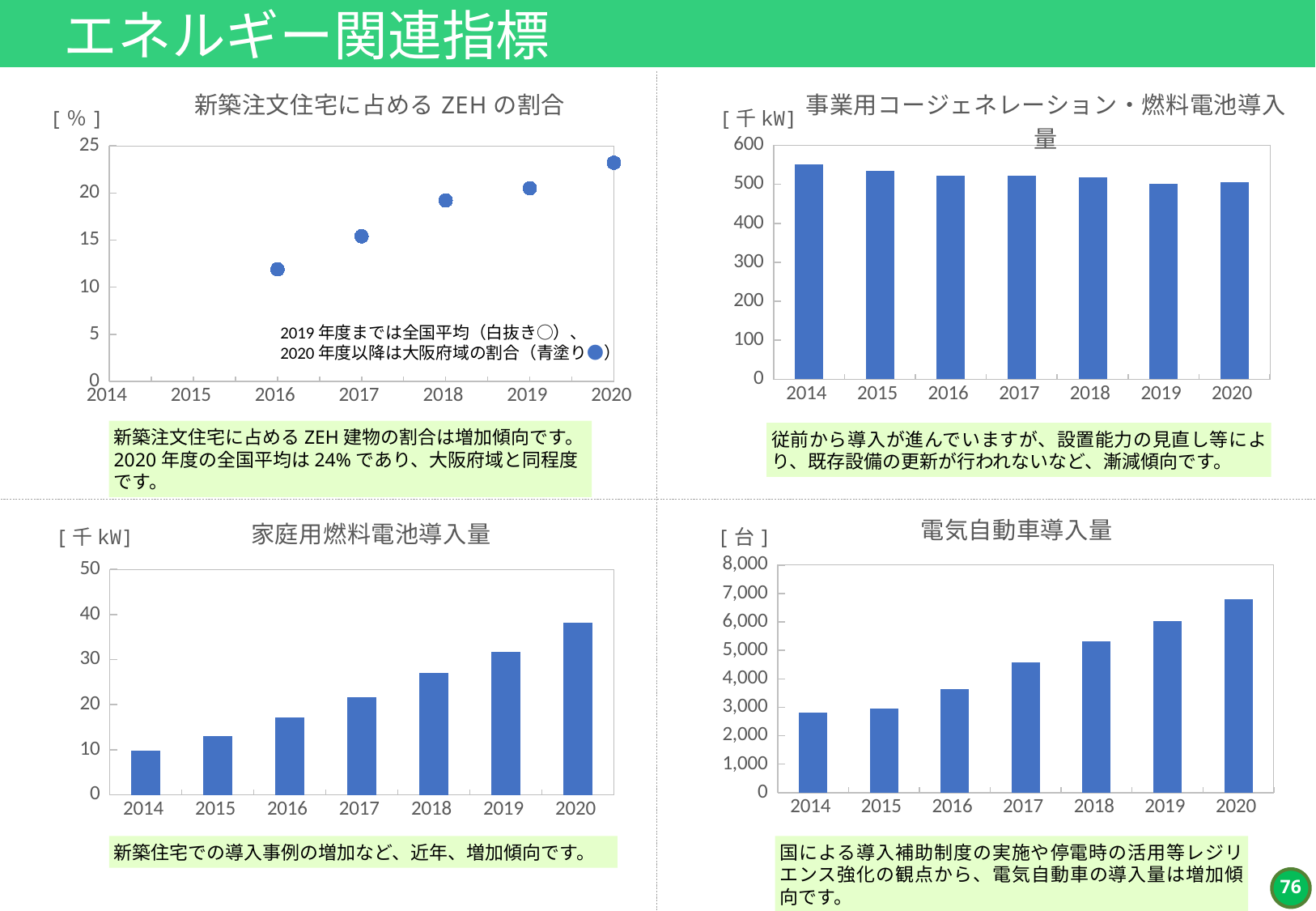
In the chart titled 事業用コージェネレーション・燃料電池導入量, which year has the highest value? 2014 In the chart titled 新築注文住宅に占めるZEHの割合, is the value for 2020 greater or less than 20? greater In the chart titled 家庭用燃料電池導入量, how many bars are shown? 7 In the chart titled 電気自動車導入量, which is larger, the value for 2017 or the value for 2019? 2019 In the chart titled 家庭用燃料電池導入量, is the value for 2020 greater or less than 30? greater In the chart titled 電気自動車導入量, is the value for 2014 greater or less than 3,000? less In the chart titled 家庭用燃料電池導入量, which year has the lowest value? 2014 In the chart titled 新築注文住宅に占めるZEHの割合, what kind of chart is it? scatter chart In the chart titled 新築注文住宅に占めるZEHの割合, how many data points are plotted? 5 In the chart titled 新築注文住宅に占めるZEHの割合, do the values rise or fall from 2016 to 2020? rise In the chart titled 事業用コージェネレーション・燃料電池導入量, do the values generally rise or fall from 2014 to 2020? fall